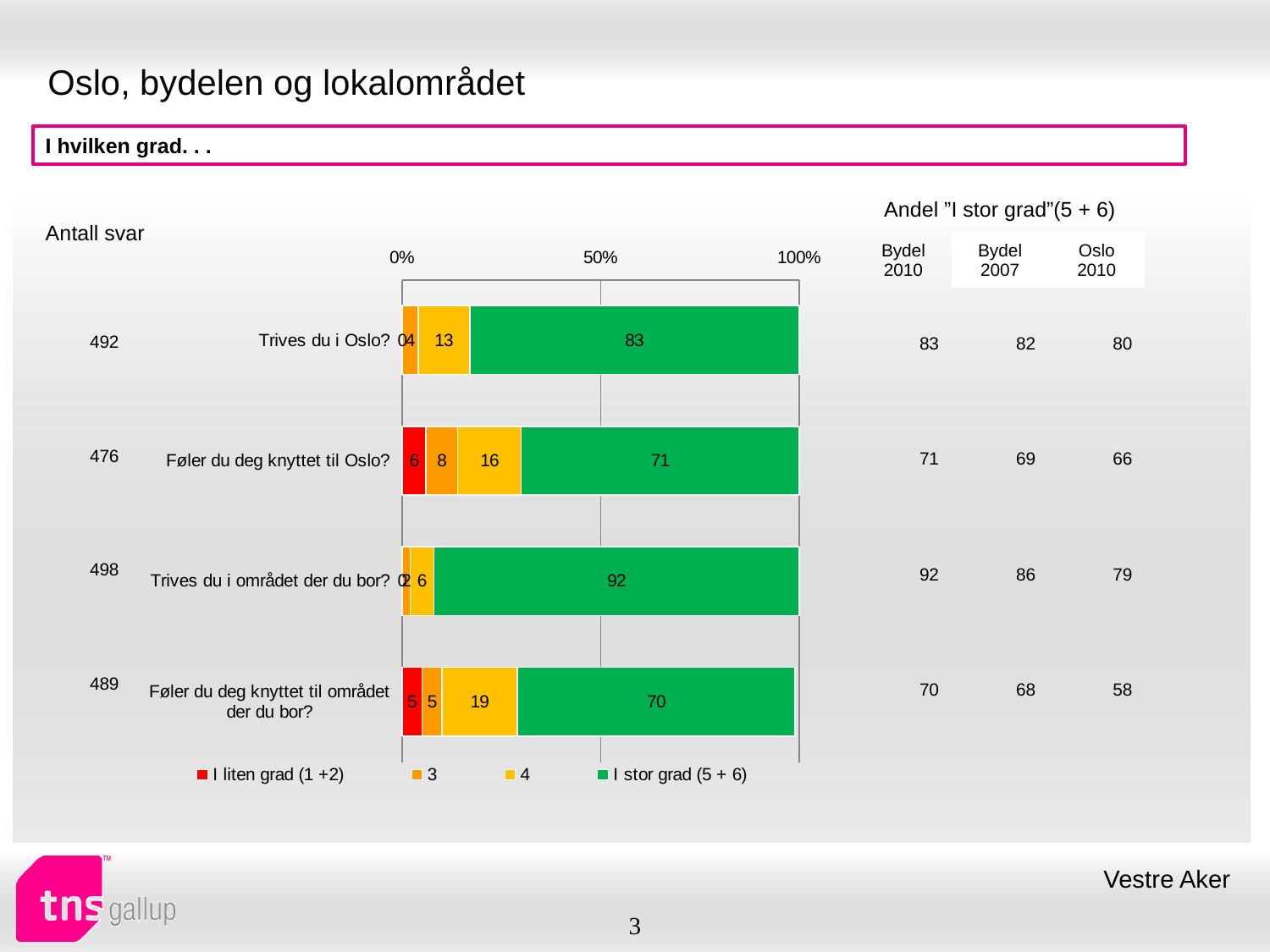
Which category has the highest 'I stor grad (5 + 6)' value? Trives du i området der du bor? Which category has the lowest 'I stor grad (5 + 6)' value? Føler du deg knyttet til området der du bor? What is the value of 'I stor grad (5 + 6)' for 'Trives du i området der du bor?'? 92 How many series does the chart legend list? 4 What is the value of 'I stor grad (5 + 6)' for 'Trives du i Oslo?'? 83 What type of chart is shown on the slide? stacked bar chart What colour represents 'I stor grad (5 + 6)' in the chart? green Which is larger: the '4' value for 'Føler du deg knyttet til Oslo?' or for 'Trives du i Oslo?'? Føler du deg knyttet til Oslo? What is the difference between the 'I stor grad (5 + 6)' values for 'Trives du i området der du bor?' and 'Føler du deg knyttet til Oslo?'? 21 What is the value of '4' for 'Føler du deg knyttet til området der du bor?'? 19 How many question categories are plotted in the chart? 4 What is the value of 'I liten grad (1 +2)' for 'Føler du deg knyttet til Oslo?'? 6